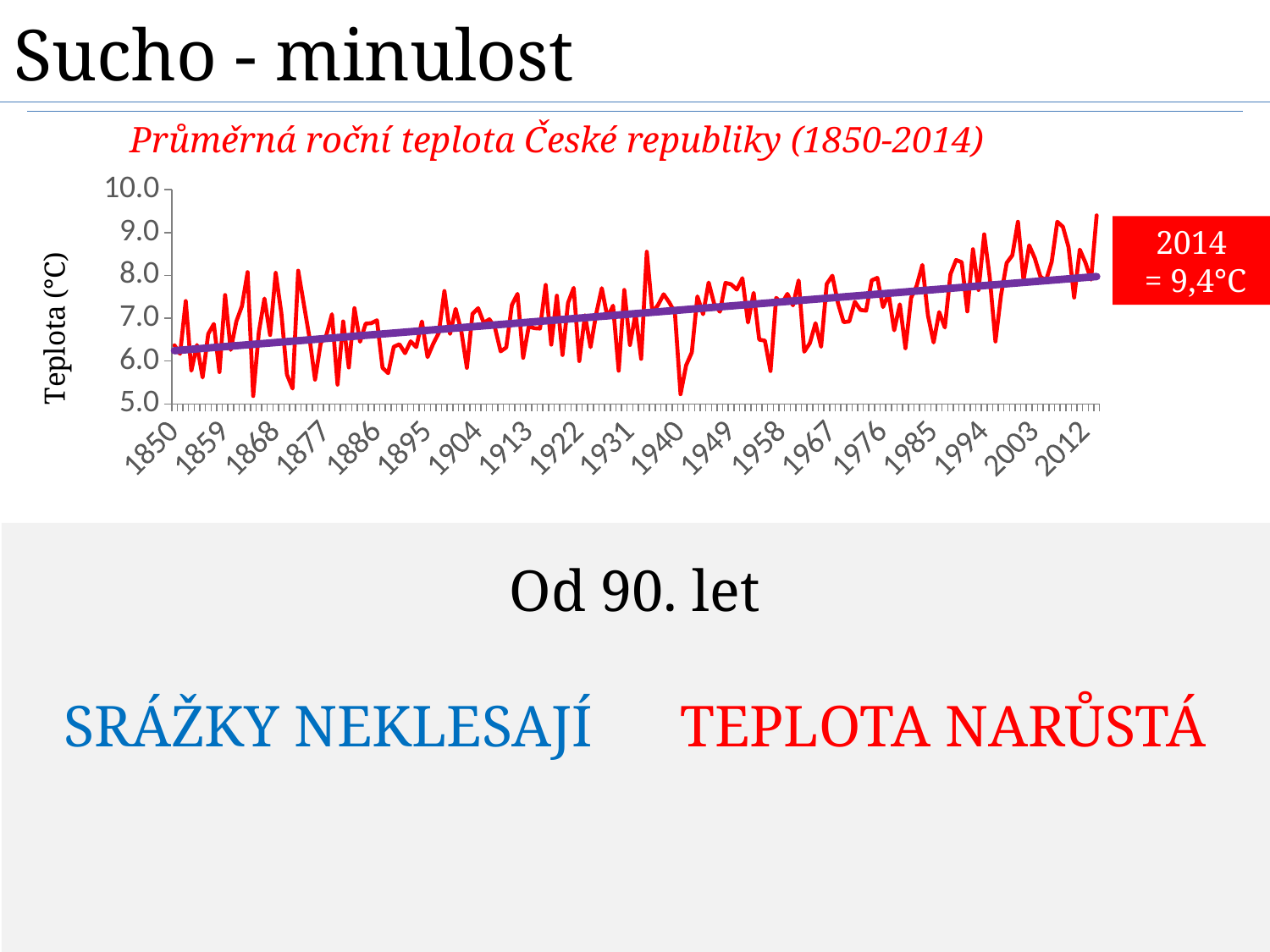
What is the label of the vertical axis? Teplota (°C) Is the trend line value at 2012 greater or less than 7.0? greater Is the value for 2014 greater or less than 9.0? greater What is the title of the chart? Průměrná roční teplota České republiky (1850-2014) What kind of chart is shown on the slide? line chart Does the trend line rise or fall from 1850 to 2014? rises Is the value for 1850 greater or less than 7.0? less Which year has the highest average annual temperature in the chart? 2014 What is the highest value shown on the vertical axis? 10.0 What is the lowest value shown on the vertical axis? 5.0 What is the average annual temperature shown for 2014? 9,4°C